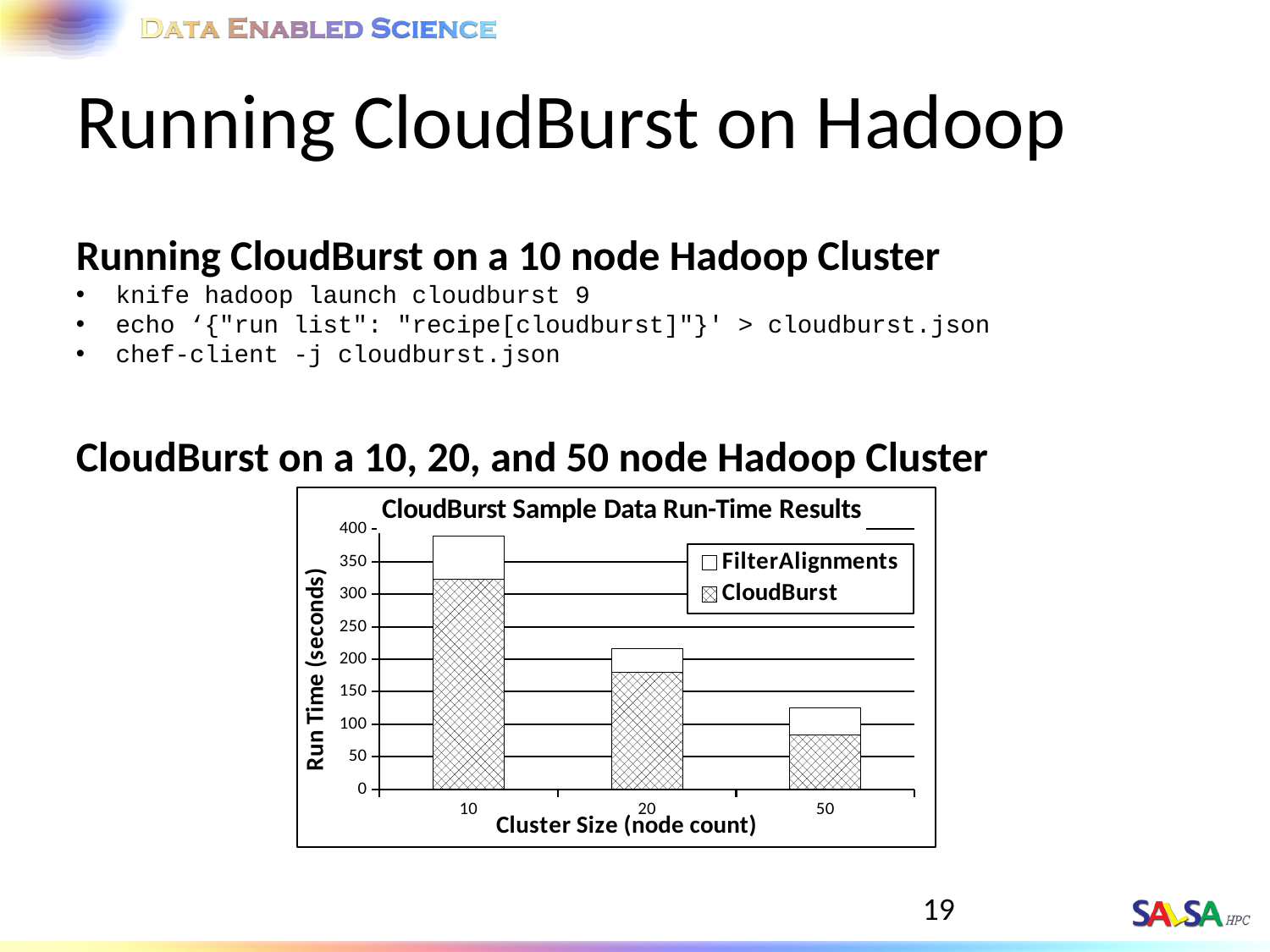
What is the label of the y axis? Run Time (seconds) Which cluster size has the highest total run time? 10 Which is larger, the CloudBurst run time for the 20 node cluster or for the 50 node cluster? 20 node cluster Is the CloudBurst run time for the 10 node cluster greater or less than 300 seconds? greater Is the total run time for the 20 node cluster greater or less than 200 seconds? greater What type of chart is shown on the slide? stacked bar chart What is the title of the chart? CloudBurst Sample Data Run-Time Results How many series does the chart legend list? 2 Is the CloudBurst run time for the 50 node cluster greater or less than 100 seconds? less Which cluster size has the lowest total run time? 50 How many cluster sizes are plotted on the x axis? 3 Does the total run time rise or fall as the cluster size increases along the x axis? fall